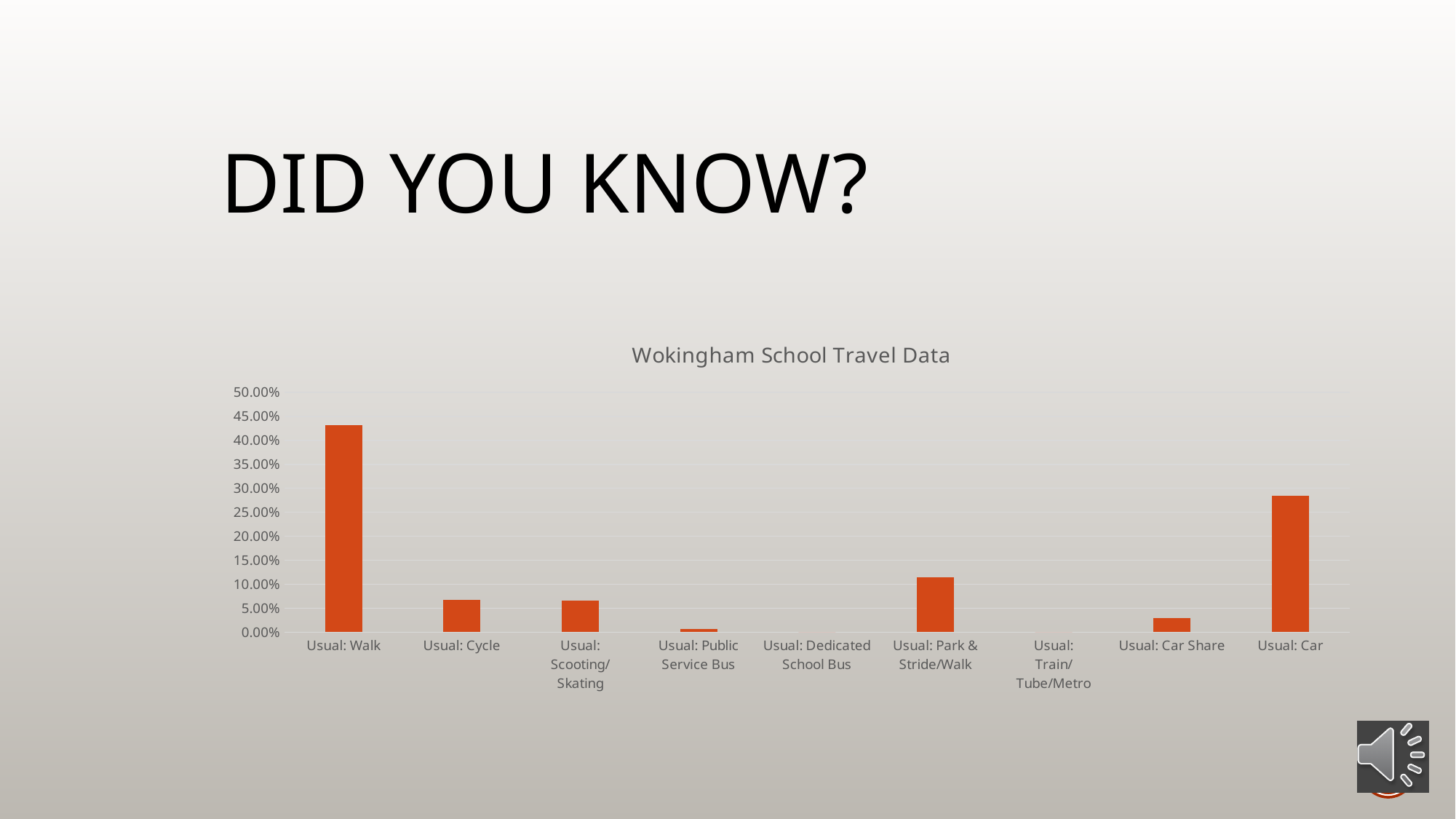
Is the value for Usual: Car Share greater or less than 5.00%? less What is the title of the chart? Wokingham School Travel Data Which category has the highest value in the chart? Usual: Walk Is the value for Usual: Walk greater or less than 40.00%? greater Is the value for Usual: Park & Stride/Walk greater or less than 10.00%? greater How many categories are shown on the x axis of the chart? 9 Which is larger, the value for Usual: Park & Stride/Walk or the value for Usual: Cycle? Usual: Park & Stride/Walk Which is larger, the value for Usual: Car or the value for Usual: Park & Stride/Walk? Usual: Car Which is larger, the value for Usual: Walk or the value for Usual: Car? Usual: Walk What type of chart is shown on the slide? bar chart